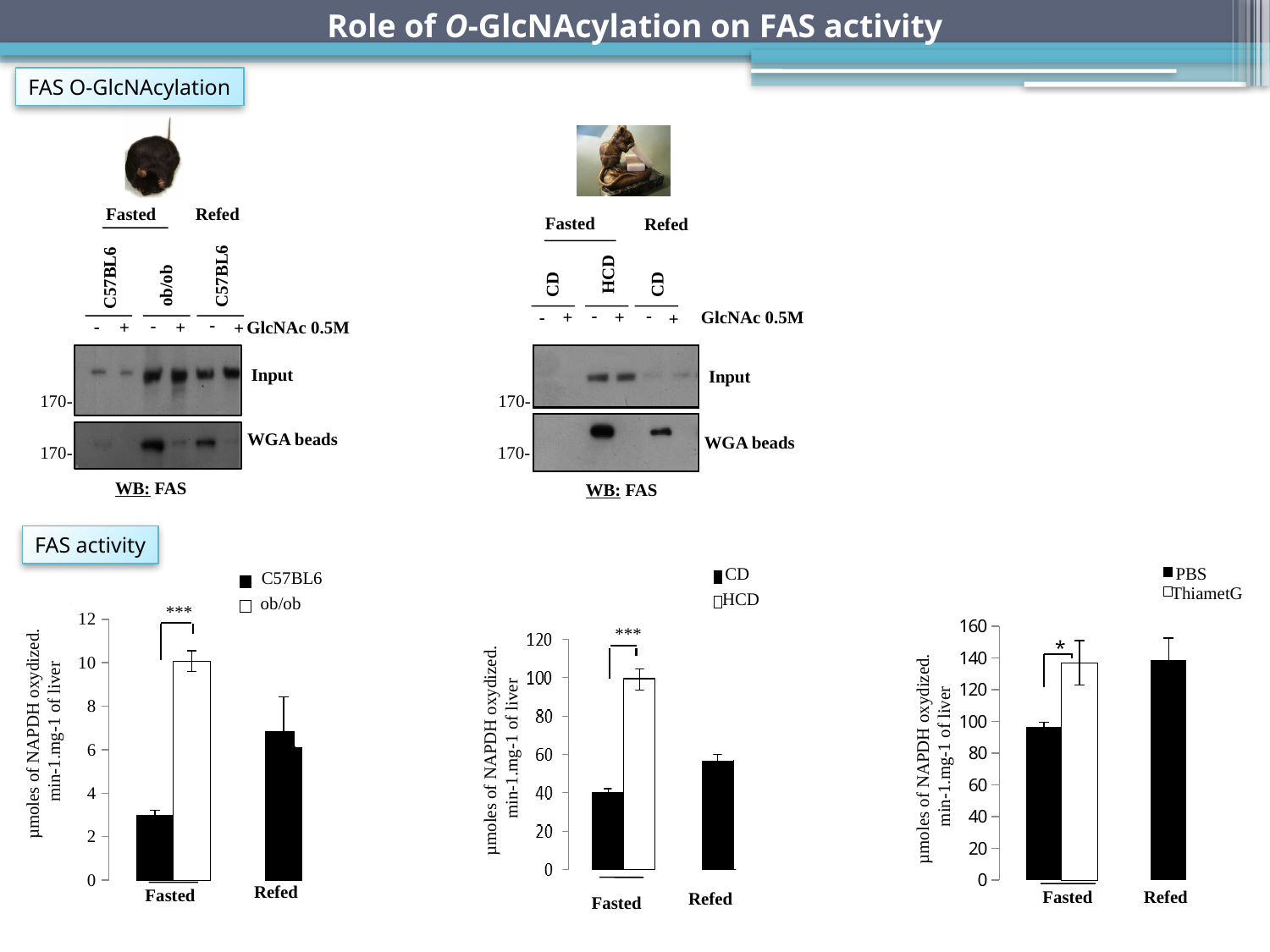
In the middle FAS activity chart, which is larger, CD Fasted or CD Refed? CD Refed In the left FAS activity chart, which series is higher in the Fasted condition, C57BL6 or ob/ob? ob/ob In the left FAS activity chart (C57BL6 vs ob/ob), what kind of chart is shown? bar chart In the middle FAS activity chart, is the value for CD in the Fasted condition greater or less than 60? less In the middle FAS activity chart (CD vs HCD), which bar is the highest? HCD, Fasted In the right FAS activity chart, what are the two series listed in the legend? PBS and ThiametG In the left FAS activity chart, how many series does the legend list? 2 In the middle FAS activity chart, is the value for HCD in the Fasted condition greater or less than 80? greater In the right FAS activity chart (PBS vs ThiametG), which bar is the lowest? PBS, Fasted In the left FAS activity chart, is the value for ob/ob in the Fasted condition greater or less than 8? greater